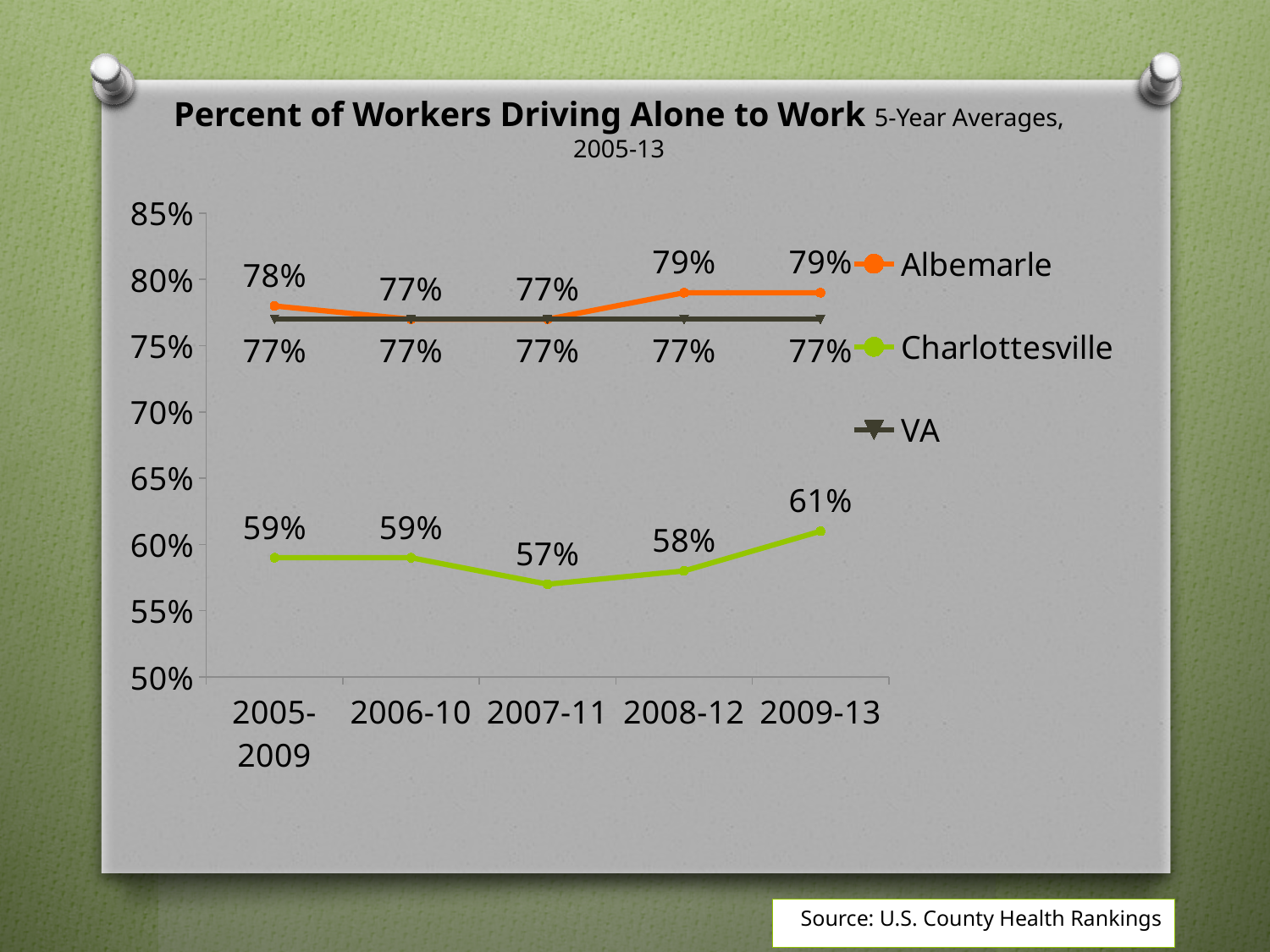
Which is larger in 2008-12, the Albemarle value or the VA value? Albemarle Does the Charlottesville value rise or fall from 2008-12 to 2009-13? Rise What kind of chart is shown on the slide? Line chart In which period is the Charlottesville value lowest? 2007-11 Which series has the lowest values across all periods? Charlottesville What is the value for VA in 2007-11? 77% What is the value for Albemarle in 2005-2009? 78% How many time periods are shown on the x axis? 5 What is the difference between the Albemarle and Charlottesville values in 2009-13? 18% How many series does the legend list? 3 What is the value for Charlottesville in 2009-13? 61% What is the title of the chart? Percent of Workers Driving Alone to Work 5-Year Averages, 2005-13